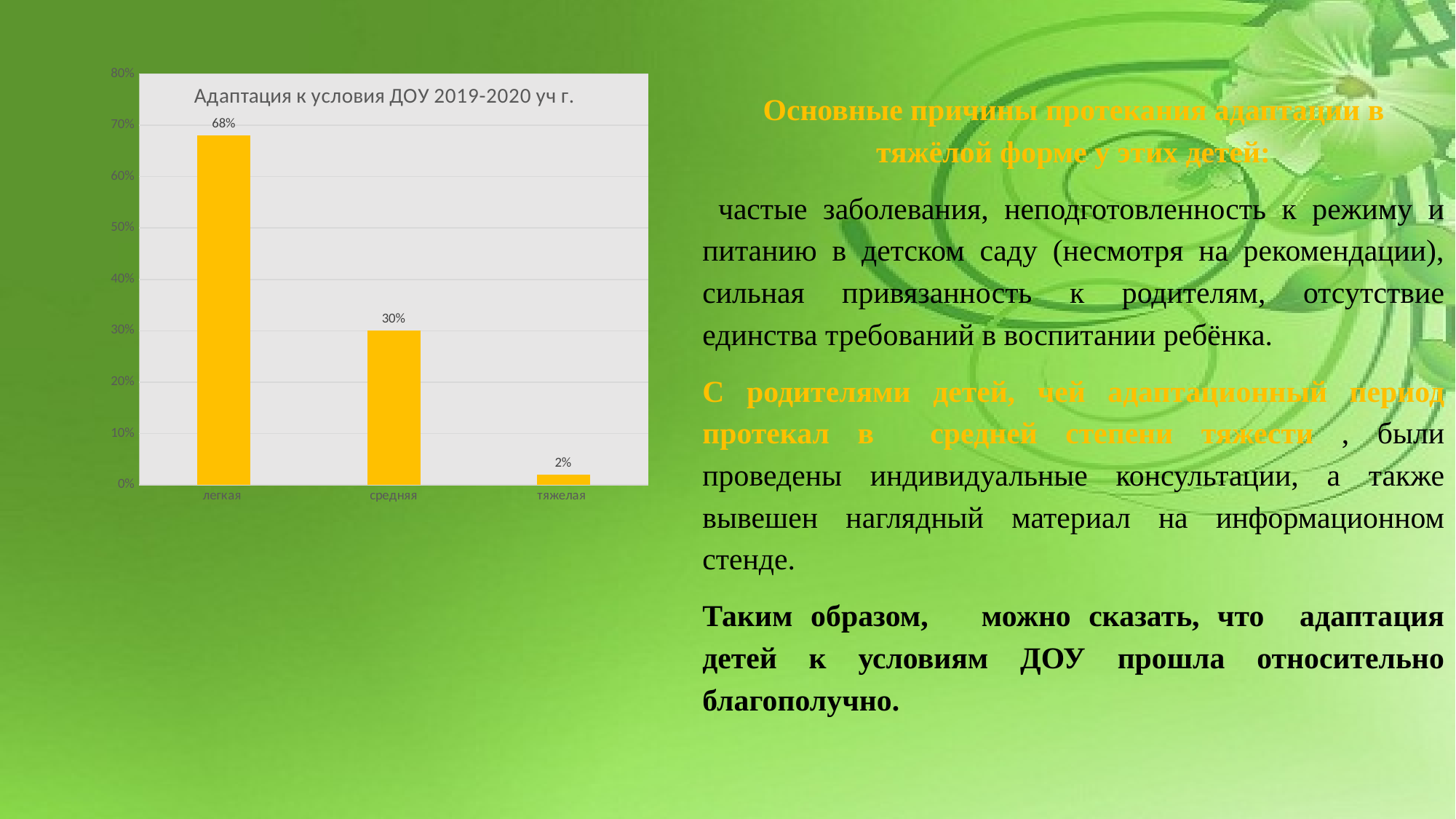
What is the difference between the values for легкая and средняя? 38% Which is larger, the value for средняя or the value for тяжелая? средняя Which category has the lowest value? тяжелая How many categories are shown on the x axis? 3 Is the value for легкая greater or less than 60%? greater What is the value for средняя? 30% What is the value for легкая? 68% What kind of chart is shown on the slide? bar chart Which category has the highest value? легкая What is the value for тяжелая? 2% What is the difference between the values for средняя and тяжелая? 28% What is the title of the chart? Адаптация к условия ДОУ 2019-2020 уч г.